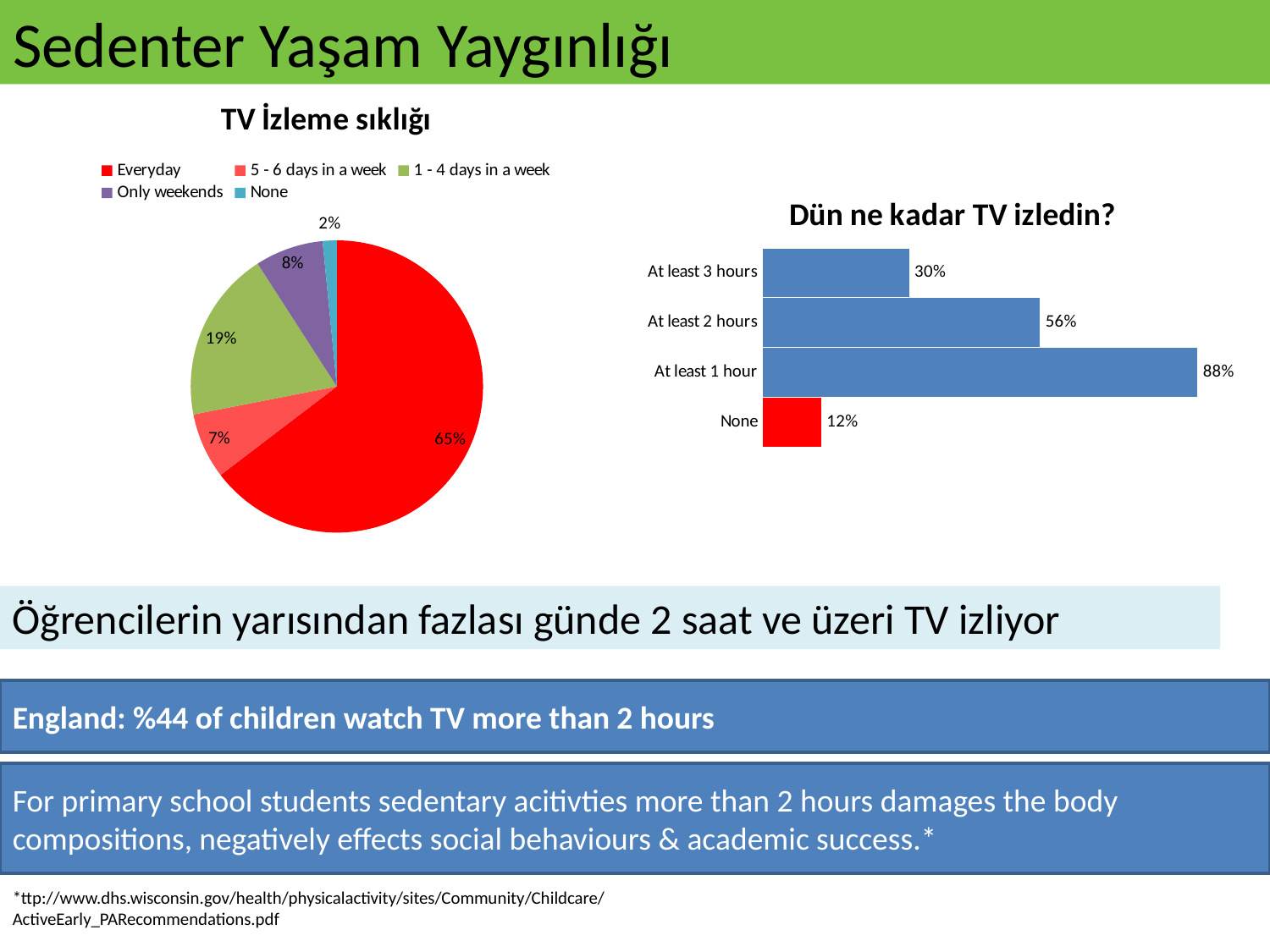
In the 'TV İzleme sıklığı' chart, how many entries does the legend list? 5 In the 'TV İzleme sıklığı' chart, what share of the pie is 'Everyday'? 65% In the 'TV İzleme sıklığı' chart, which category has the smallest slice? None In the 'TV İzleme sıklığı' chart, what share of the pie is 'Only weekends'? 8% What kind of chart is 'Dün ne kadar TV izledin?'? Bar chart In the 'TV İzleme sıklığı' chart, what share of the pie is '1 - 4 days in a week'? 19% In the 'Dün ne kadar TV izledin?' chart, what is the value for 'At least 2 hours'? 56% In the 'Dün ne kadar TV izledin?' chart, which category has the highest value? At least 1 hour In the 'Dün ne kadar TV izledin?' chart, what is the difference between 'At least 1 hour' and 'At least 3 hours'? 58% In the 'Dün ne kadar TV izledin?' chart, how many categories are shown? 4 What kind of chart is 'TV İzleme sıklığı'? Pie chart In the 'Dün ne kadar TV izledin?' chart, what is the value for 'None'? 12%